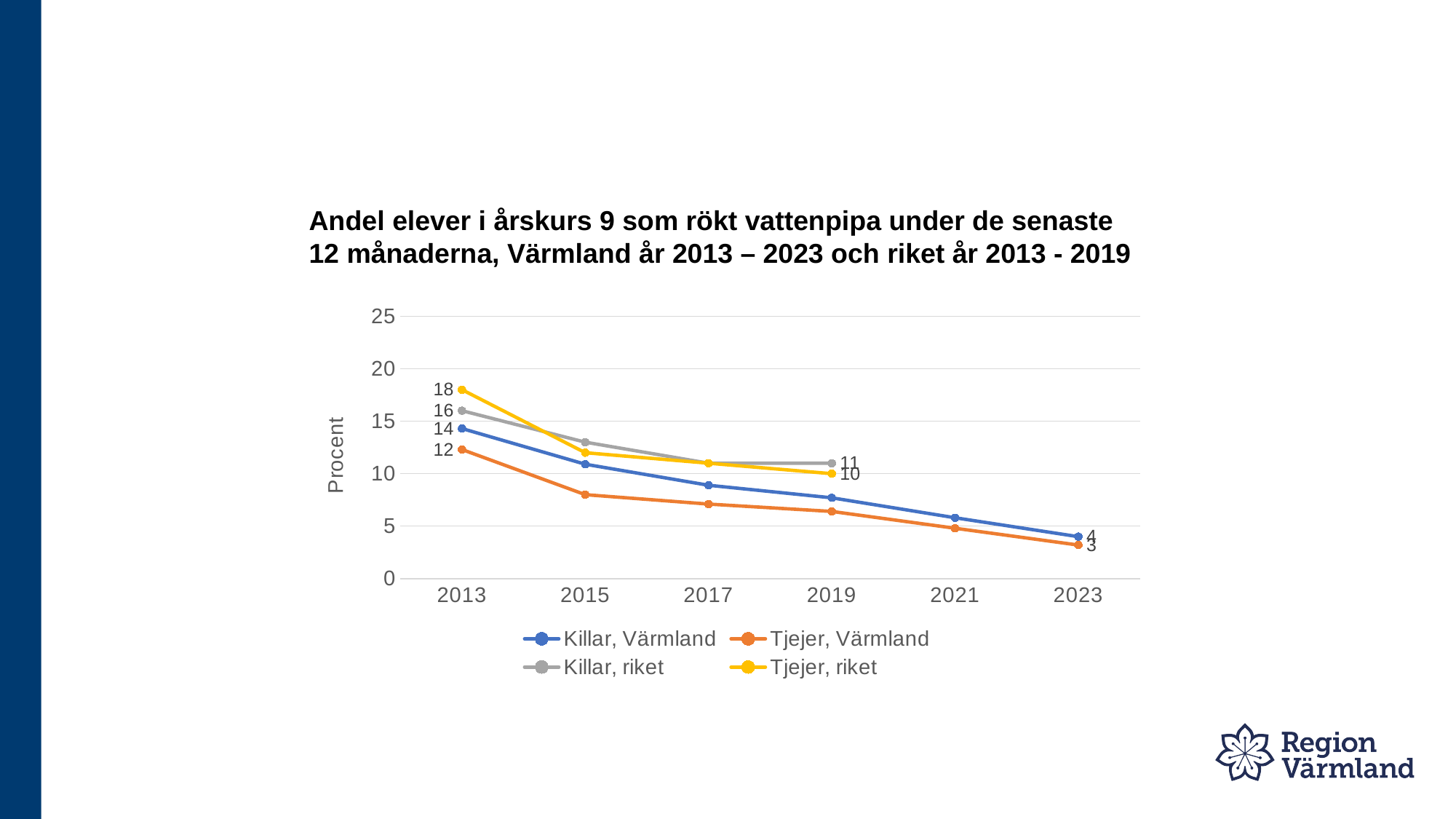
Which series has the highest value in 2013? Tjejer, riket How many series does the legend list? 4 What is the value for Killar, riket in 2019? 11 What is the label on the y axis? Procent How many years are shown on the x axis? 6 Does the Killar, Värmland series rise or fall from 2013 to 2023? falls What kind of chart is shown on the slide? line chart In 2019, which is larger: Killar, riket or Tjejer, riket? Killar, riket What is the value for Tjejer, riket in 2013? 18 Is the value for Tjejer, Värmland in 2015 greater or less than 10? less What is the value for Killar, Värmland in 2023? 4 What is the difference between Killar, Värmland and Tjejer, Värmland in 2013? 2